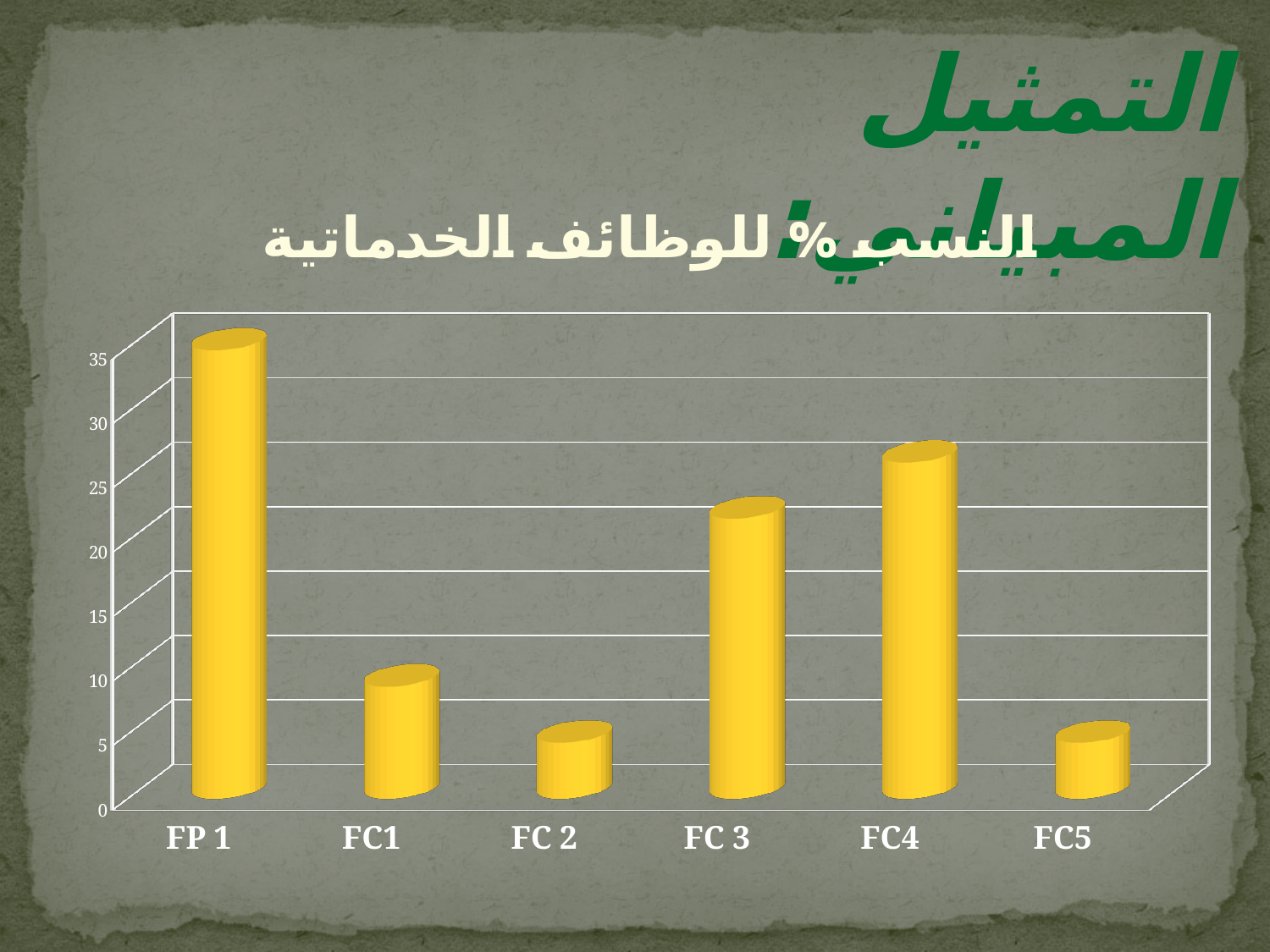
Which category has the highest bar in the chart? FP 1 Is the value for FC4 greater or less than 20? greater Is the value for FC5 greater or less than 10? less How many categories are shown on the x axis of the chart? 6 Is the value for FC 2 greater or less than 10? less Which is larger, the value for FC4 or the value for FC 3? FC4 Which is larger, the value for FC1 or the value for FC 2? FC1 What colour are the bars in the chart? yellow What kind of chart is shown on the slide? bar chart Which is larger, the value for FP 1 or the value for FC4? FP 1